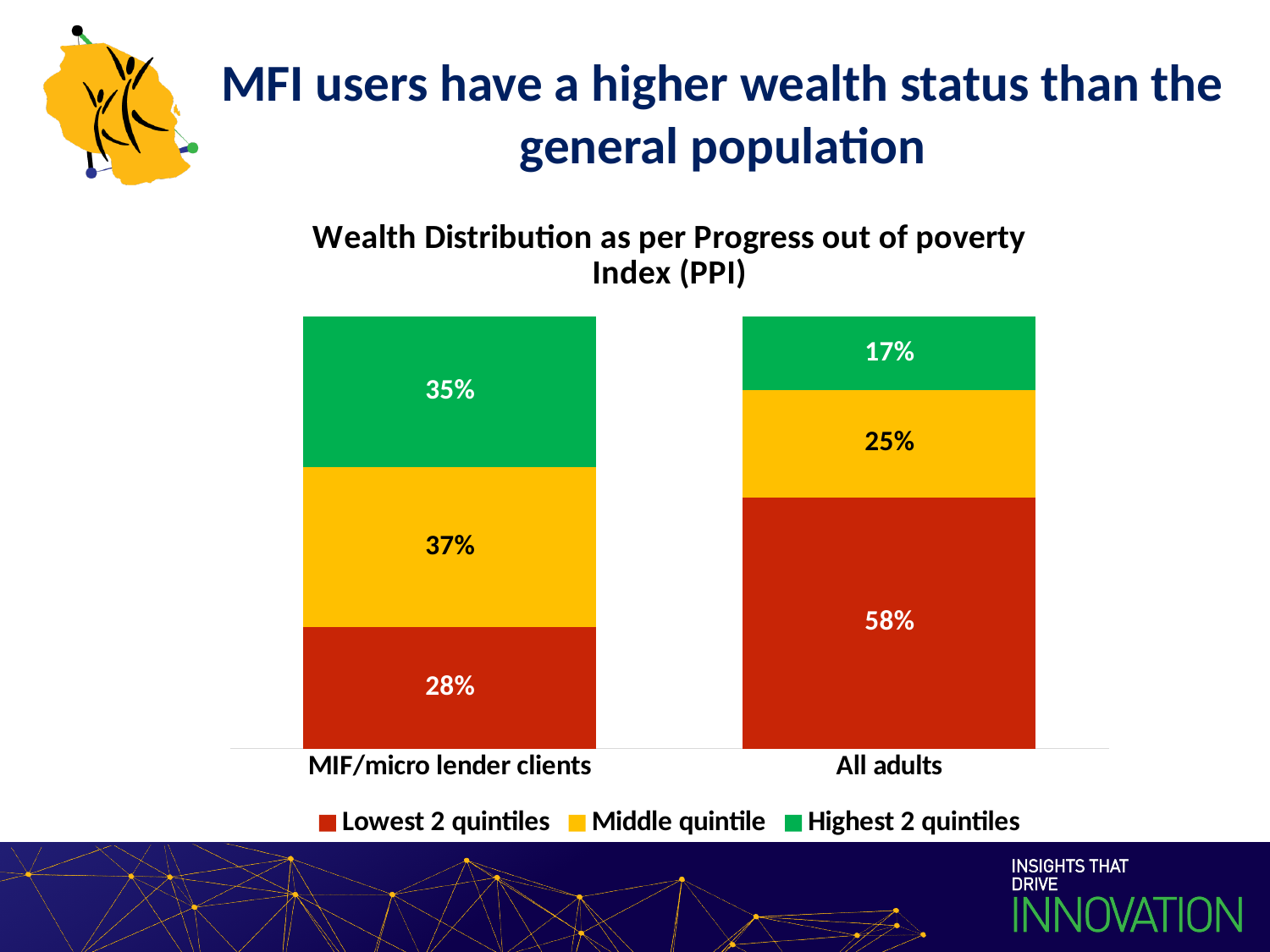
What is the Middle quintile value for All adults? 25% Which category has the higher Lowest 2 quintiles share, MIF/micro lender clients or All adults? All adults What percentage of MIF/micro lender clients are in the Lowest 2 quintiles? 28% How many categories are shown on the x axis? 2 What is the difference between the Lowest 2 quintiles share for All adults and for MIF/micro lender clients? 30% What type of chart is shown? Stacked bar chart What is the Highest 2 quintiles value for MIF/micro lender clients? 35% What percentage of All adults are in the Highest 2 quintiles? 17% Which segment is the smallest in the All adults bar? Highest 2 quintiles Which segment is the largest in the All adults bar? Lowest 2 quintiles What is the difference between the Highest 2 quintiles share for MIF/micro lender clients and for All adults? 18% How many series does the legend list? 3